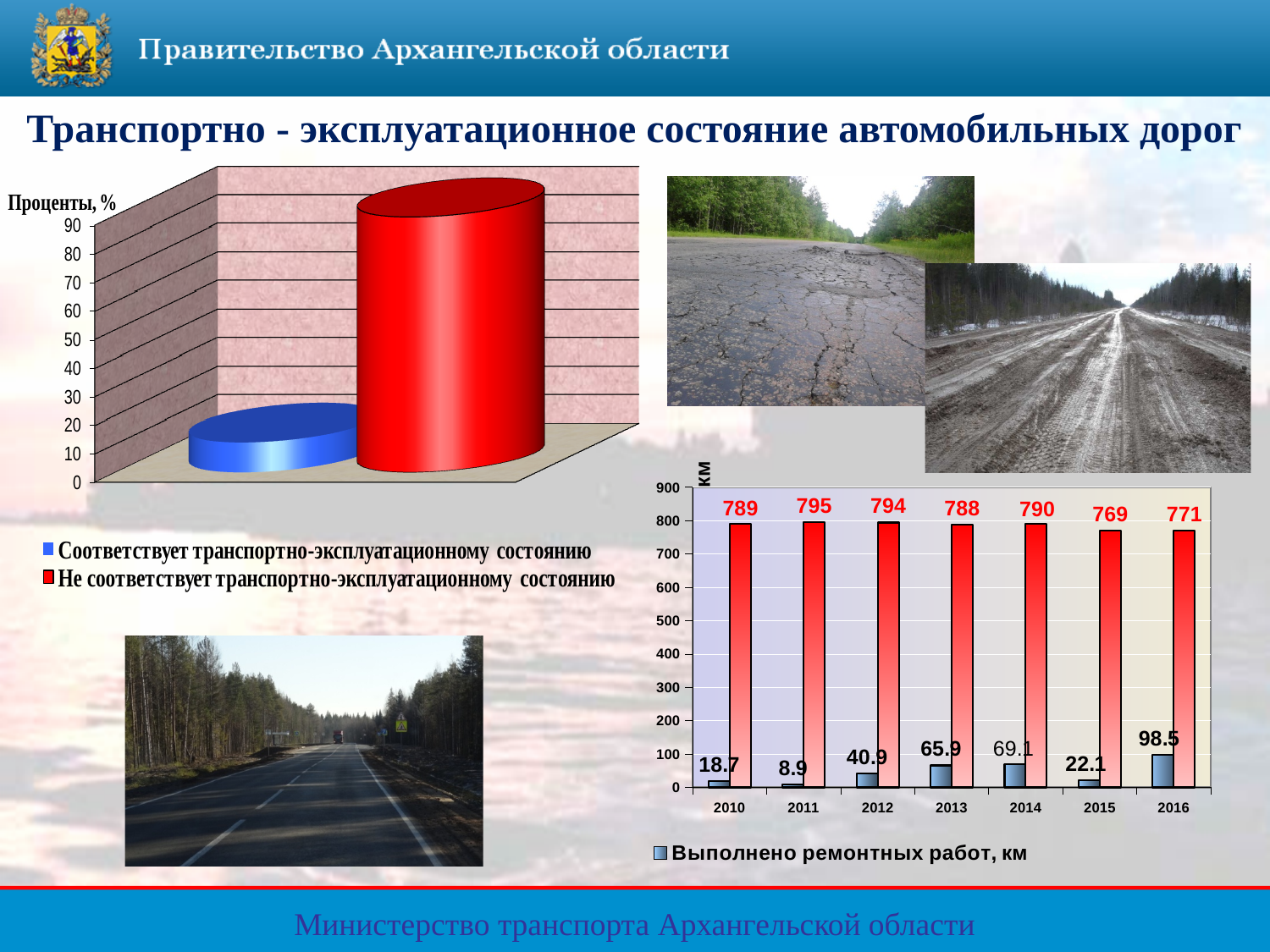
In the bar chart on the right, what is the value of 'Выполнено ремонтных работ, км' for 2016? 98.5 What kind of chart is the chart on the right? bar chart In the bar chart on the right, which year has the lowest red bar value? 2015 How many years are shown on the x axis of the bar chart on the right? 7 In the bar chart on the right, what is the difference between the 'Выполнено ремонтных работ, км' values for 2016 and 2010? 79.8 In the bar chart on the right, what is the value of the red bar for 2011? 795 In the bar chart on the right, what is the value of 'Выполнено ремонтных работ, км' for 2013? 65.9 How many series does the legend of the 3D chart on the left list? 2 In the bar chart on the right, which year has the highest value of 'Выполнено ремонтных работ, км'? 2016 In the 3D chart on the left, is the value of the red cylinder ('Не соответствует транспортно-эксплуатационному состоянию') greater or less than 50? greater In the bar chart on the right, which is larger: the red bar value for 2012 or for 2014? 2012 In the bar chart on the right, which year has the lowest value of 'Выполнено ремонтных работ, км'? 2011